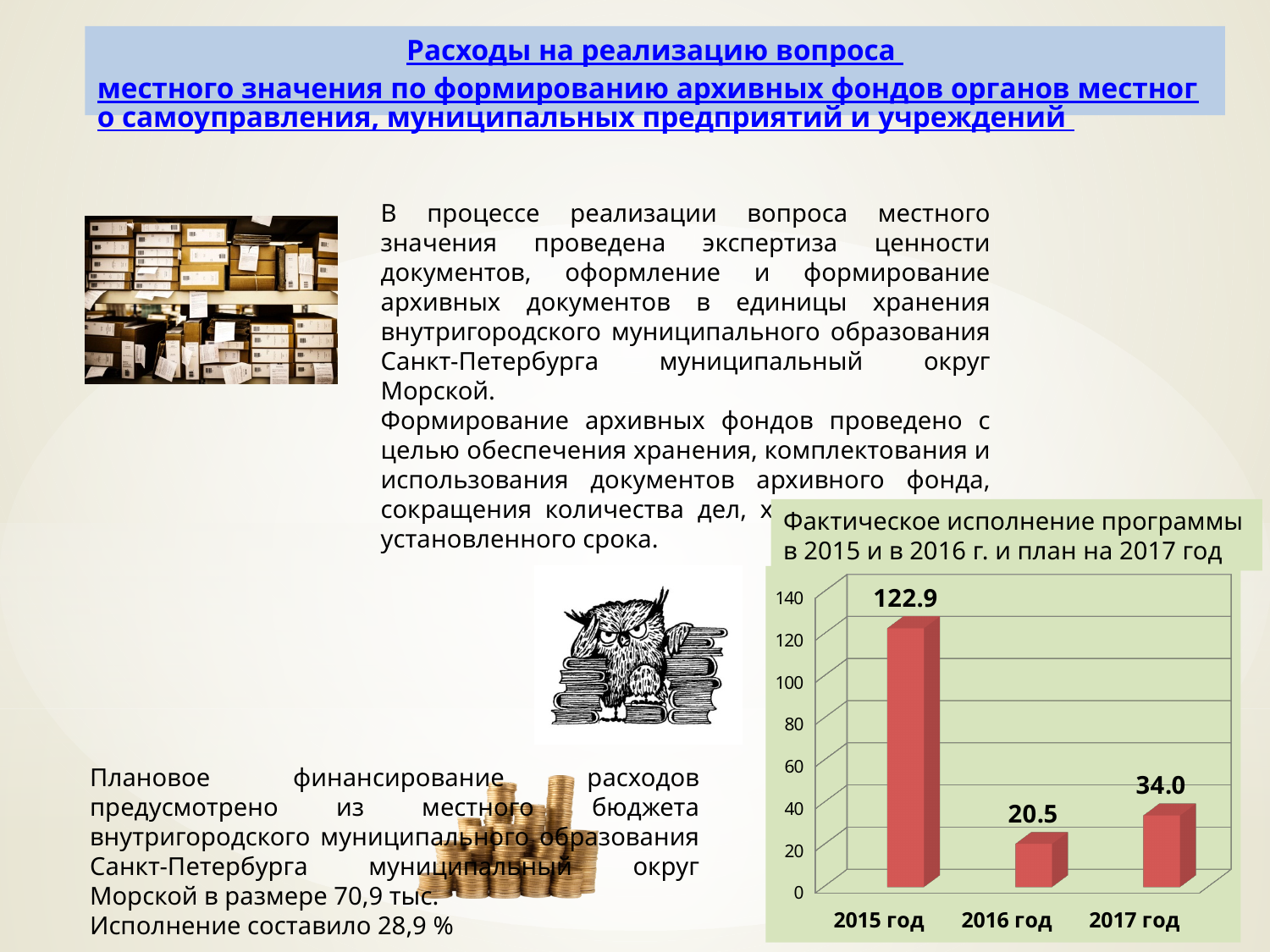
What kind of chart is shown on the slide? bar chart What is the value for 2015 год? 122.9 Which year has the highest value? 2015 год Which year has the lowest value? 2016 год What is the value for 2016 год? 20.5 How many categories are shown on the x axis? 3 Which is larger, the value for 2016 год or 2017 год? 2017 год What is the title of the chart? Фактическое исполнение программы в 2015 и в 2016 г. и план на 2017 год What is the value for 2017 год? 34.0 Is the value for 2015 год greater or less than 100? greater What is the difference between the values for 2015 год and 2016 год? 102.4 What is the difference between the values for 2017 год and 2016 год? 13.5